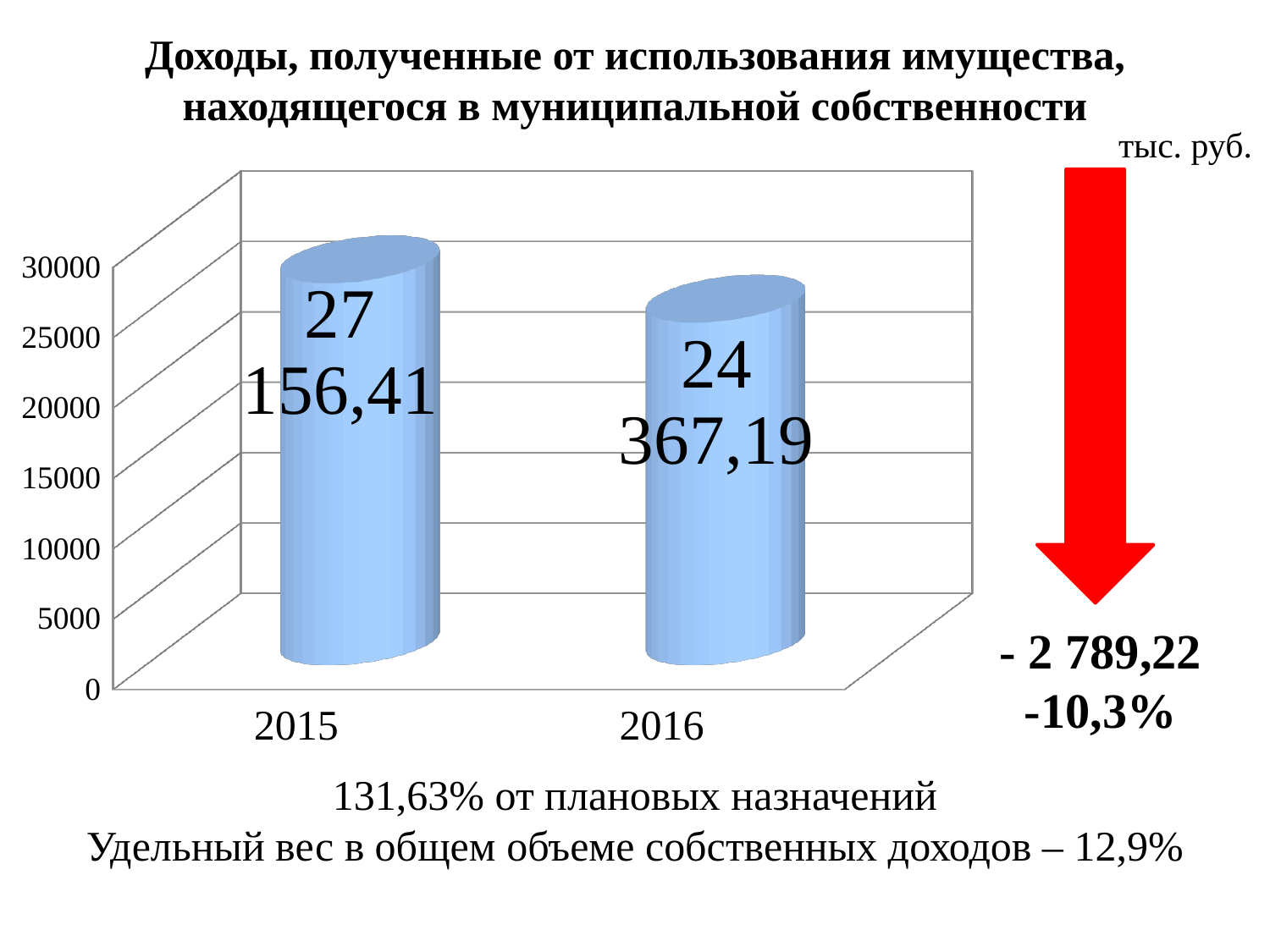
What is the value for 2015? 27 156,41 What unit of measurement is indicated for the chart values? тыс. руб. Is the value for 2015 greater or less than 25000? greater Is the value for 2016 larger or smaller than the value for 2015? smaller Is the value for 2016 greater or less than 25000? less Do the values rise or fall from 2015 to 2016? fall What is the value for 2016? 24 367,19 What kind of chart is shown on the slide? bar chart How many years are shown on the chart? 2 Which year has the higher value? 2015 Which year has the lower value? 2016 What is the difference between the 2015 value and the 2016 value? 2 789,22